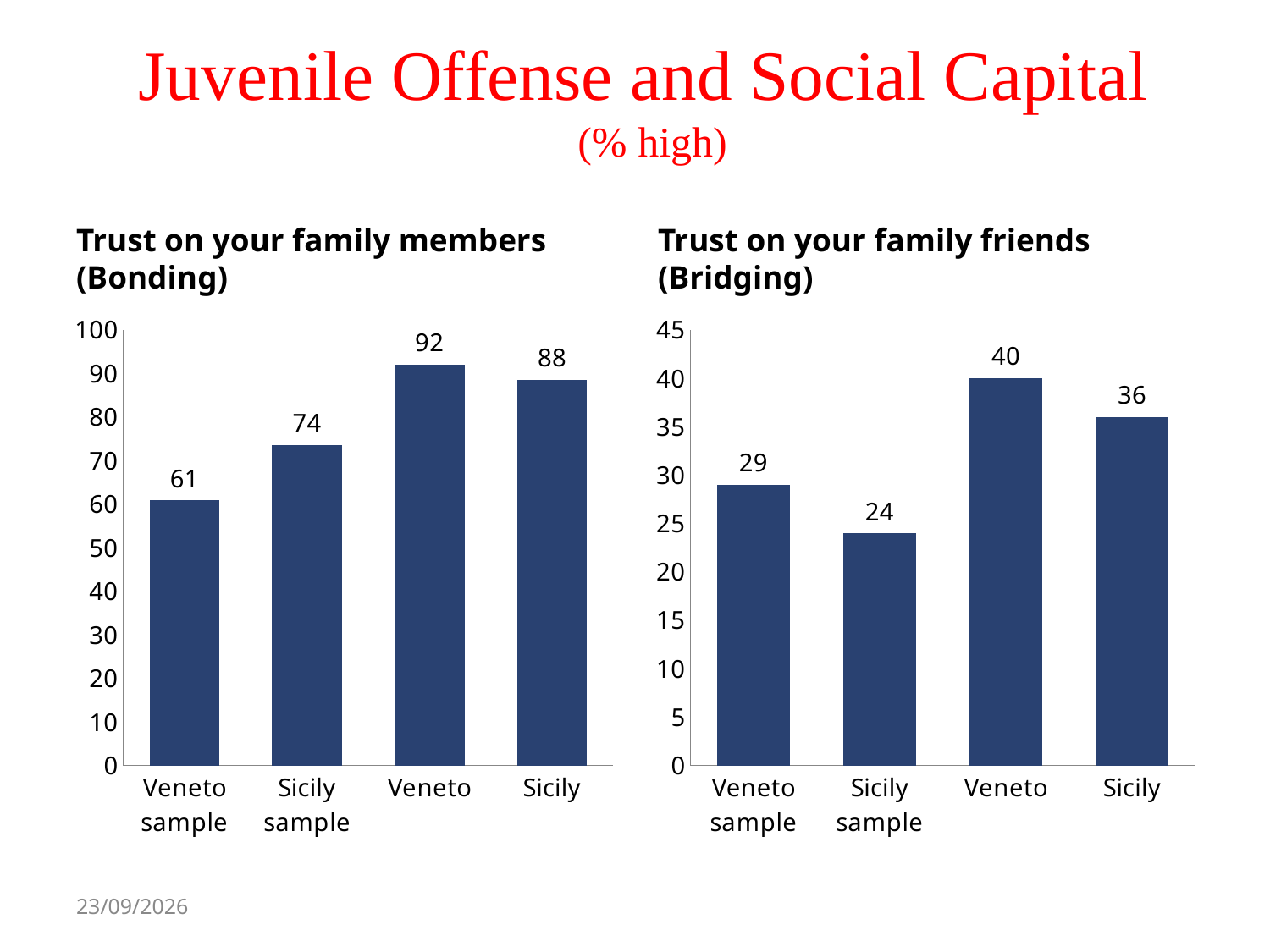
In the 'Trust on your family friends (Bridging)' chart, which is larger, the value for Veneto sample or the value for Sicily sample? Veneto sample In the 'Trust on your family members (Bonding)' chart, which category has the highest value? Veneto In the 'Trust on your family members (Bonding)' chart, which category has the lowest value? Veneto sample In the 'Trust on your family members (Bonding)' chart, what is the value for Sicily sample? 74 In the 'Trust on your family friends (Bridging)' chart, which category has the lowest value? Sicily sample How many bars are in the 'Trust on your family members (Bonding)' chart? 4 In the 'Trust on your family friends (Bridging)' chart, what is the difference between the Veneto sample value and the Sicily sample value? 5 In the 'Trust on your family friends (Bridging)' chart, what is the value for Veneto? 40 What type of chart is the 'Trust on your family friends (Bridging)' chart? Bar chart In the 'Trust on your family members (Bonding)' chart, what is the value for Veneto sample? 61 In the 'Trust on your family friends (Bridging)' chart, what is the value for Sicily sample? 24 In the 'Trust on your family members (Bonding)' chart, what is the difference between the Veneto value and the Sicily value? 4